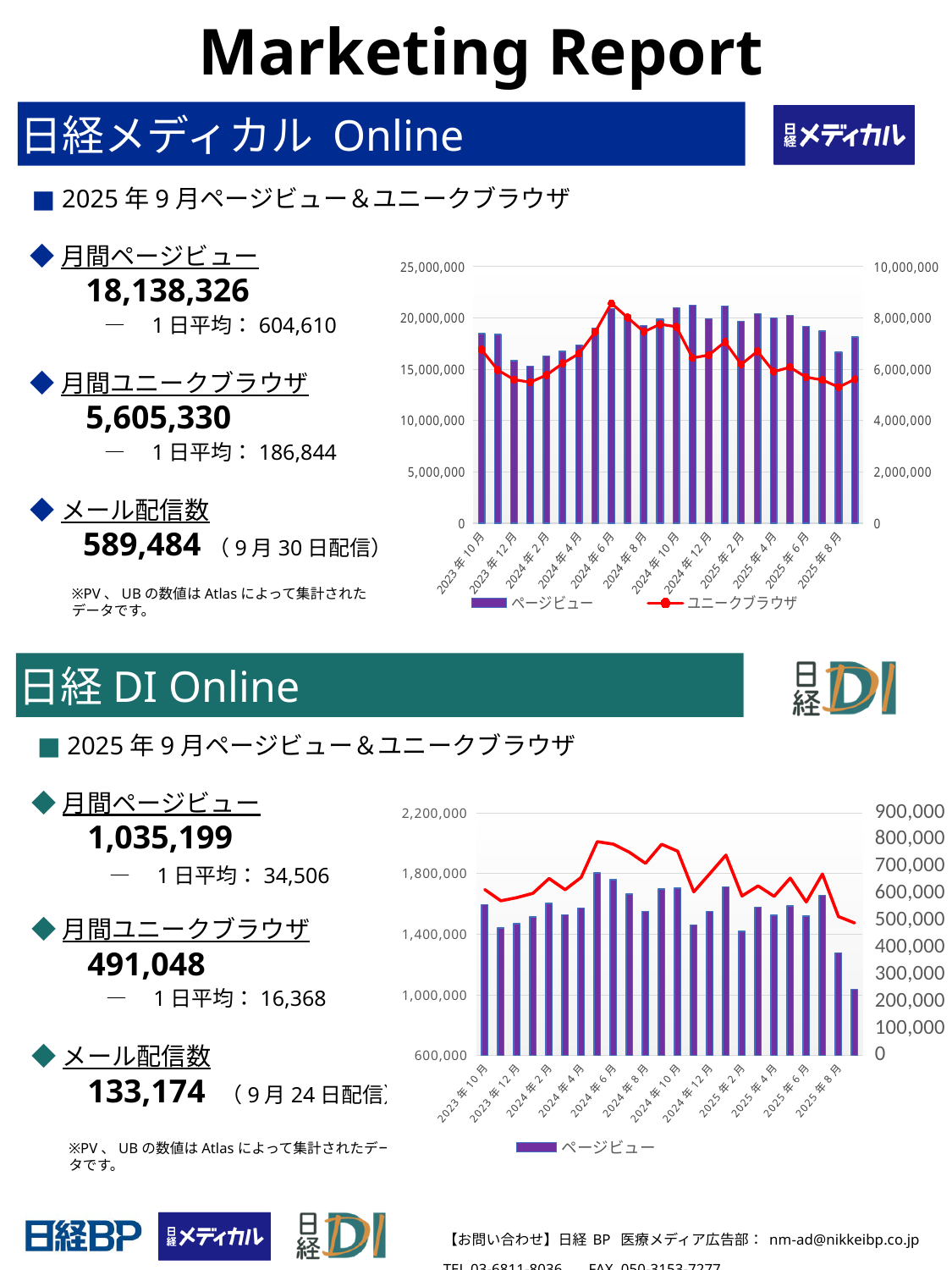
On the 日経メディカル Online chart, is the ページビュー value for 2025年8月 greater or less than 20,000,000? less On the 日経 DI Online chart, how many series does the legend list? 1 On the 日経メディカル Online chart, what colour is the ユニークブラウザ line? red On the 日経メディカル Online chart, which month has the highest ユニークブラウザ value? 2024年6月 On the 日経メディカル Online chart, is the ページビュー value for 2024年6月 greater or less than 20,000,000? greater On the 日経メディカル Online chart, is the ユニークブラウザ value for 2024年6月 greater or less than 8,000,000? greater On the 日経 DI Online chart, which month has the highest ページビュー bar? 2024年5月 On the 日経メディカル Online chart, which has the larger ページビュー value, 2024年2月 or 2024年6月? 2024年6月 On the 日経メディカル Online chart, how many series does the legend list? 2 On the 日経メディカル Online chart, what kind of chart is it? bar and line chart